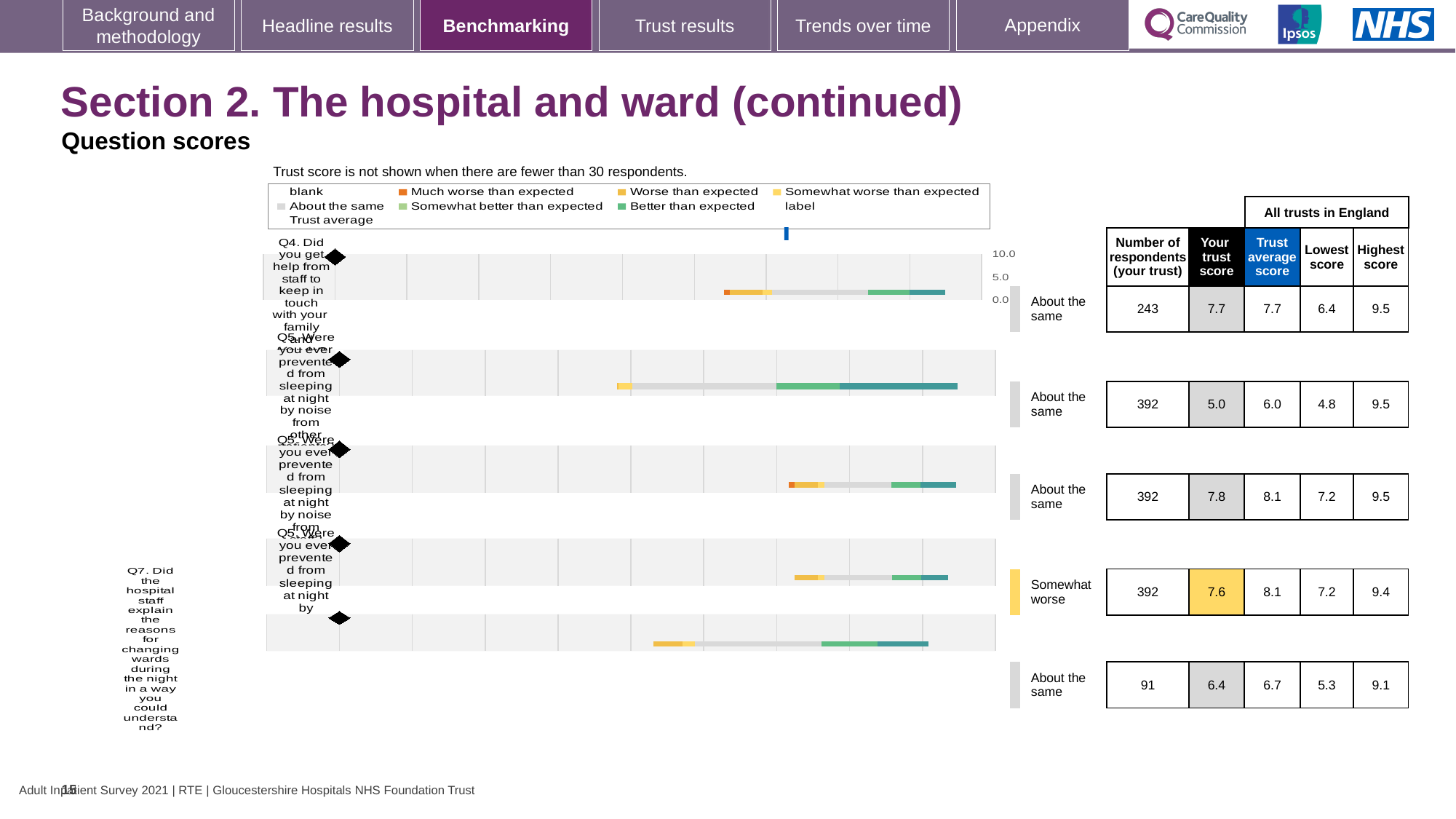
How many question rows are plotted in the chart? 5 Which is larger, your trust score for Q4 or your trust score for Q7? Q4 What is the difference between the highest and lowest scores in England for Q7? 3.8 What kind of chart is used to show the question scores on this slide? bar chart What is your trust score for Q4 (help from staff to keep in touch with family and friends)? 7.7 What is your trust score for Q7 (explaining reasons for changing wards during the night)? 6.4 How many respondents from your trust answered Q4 (help from staff to keep in touch with family and friends)? 243 Which question row has the fewest respondents from your trust? Q7 (91 respondents) Which question row is rated 'Somewhat worse' rather than 'About the same'? the fourth row Which question row has the lowest 'Your trust score'? the second row (5.0) What is the highest score across all trusts in England for Q4? 9.5 What is the lowest score across all trusts in England for Q7? 5.3